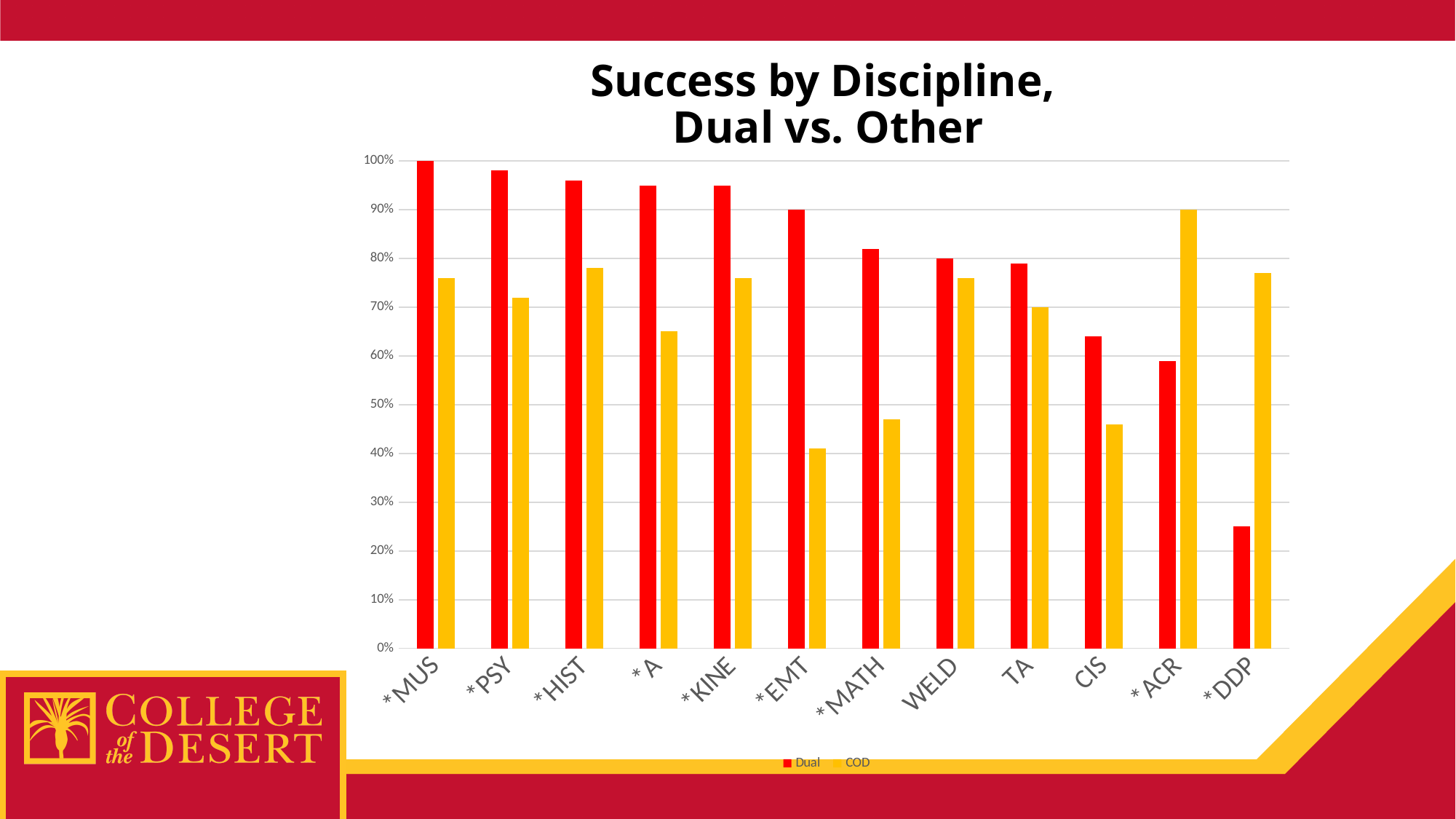
What kind of chart is shown on the slide? bar chart Is the Dual value for CIS greater or less than 60%? greater Which discipline has the lowest Dual success rate? *DDP Which discipline has the lowest COD success rate? *EMT Which discipline has the highest COD success rate? *ACR How many disciplines are shown along the x axis? 12 For *DDP, which is larger, the Dual value or the COD value? COD Is the COD value for *EMT greater or less than 50%? less Do the Dual values rise or fall moving left to right along the x axis? fall Which discipline has the highest Dual success rate? *MUS For *KINE, which is larger, the Dual value or the COD value? Dual How many series does the legend list? 2